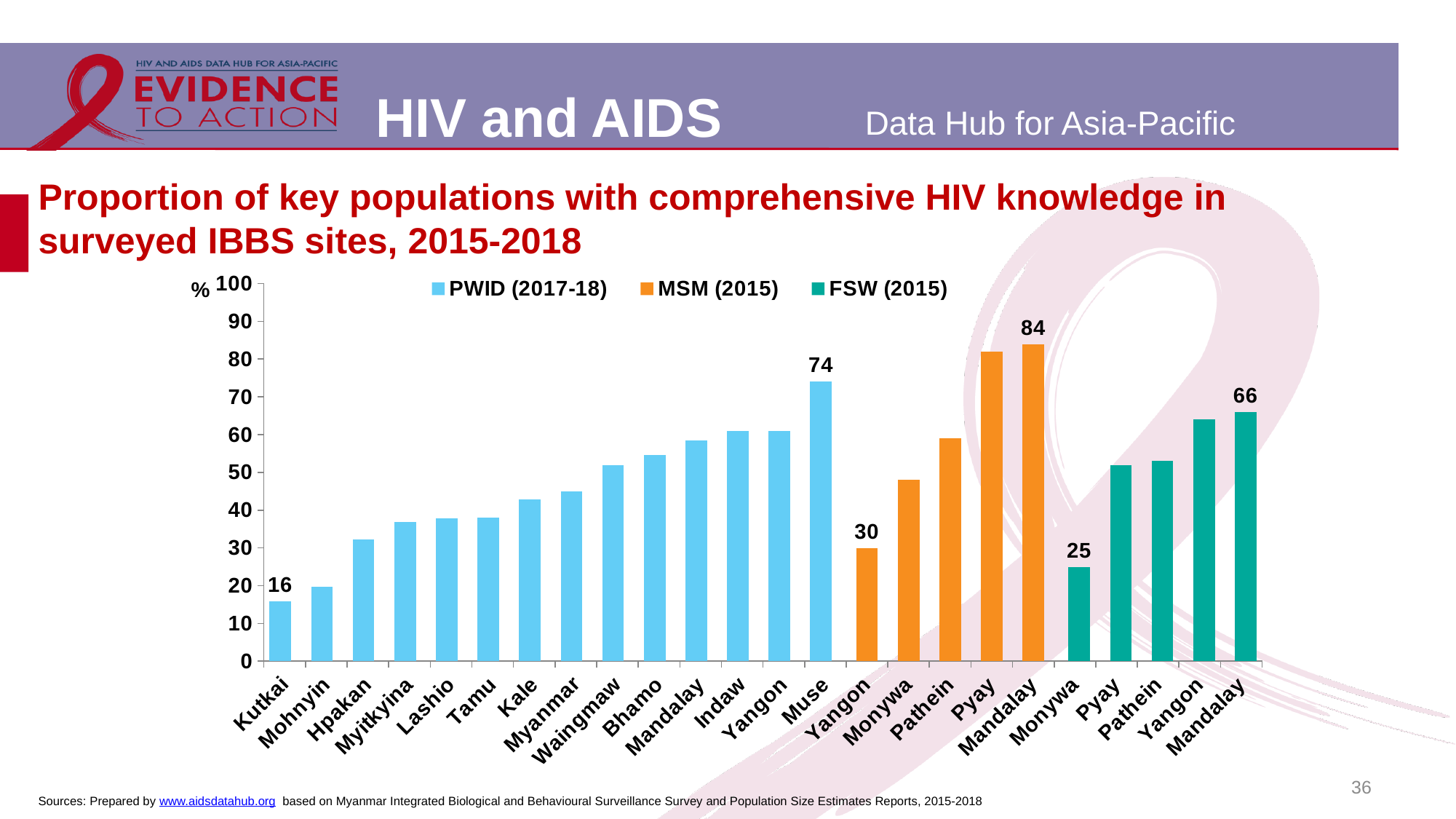
What is the value for Kutkai in the PWID (2017-18) series? 16 What is the difference between the values for Muse and Kutkai in the PWID (2017-18) series? 58 What kind of chart is shown on the slide? bar chart Which site and series has the highest value on the chart? Mandalay, MSM (2015) What is the value for Muse in the PWID (2017-18) series? 74 Which site has the lowest value on the chart? Kutkai Which is larger: the value for Mandalay in the MSM (2015) series or the value for Mandalay in the FSW (2015) series? MSM (2015) What is the value for Mandalay in the MSM (2015) series? 84 How many series does the legend list? 3 What is the difference between the values for Mandalay and Yangon in the MSM (2015) series? 54 Is the value for Hpakan in the PWID (2017-18) series greater or less than 40? less What is the value for Monywa in the FSW (2015) series? 25